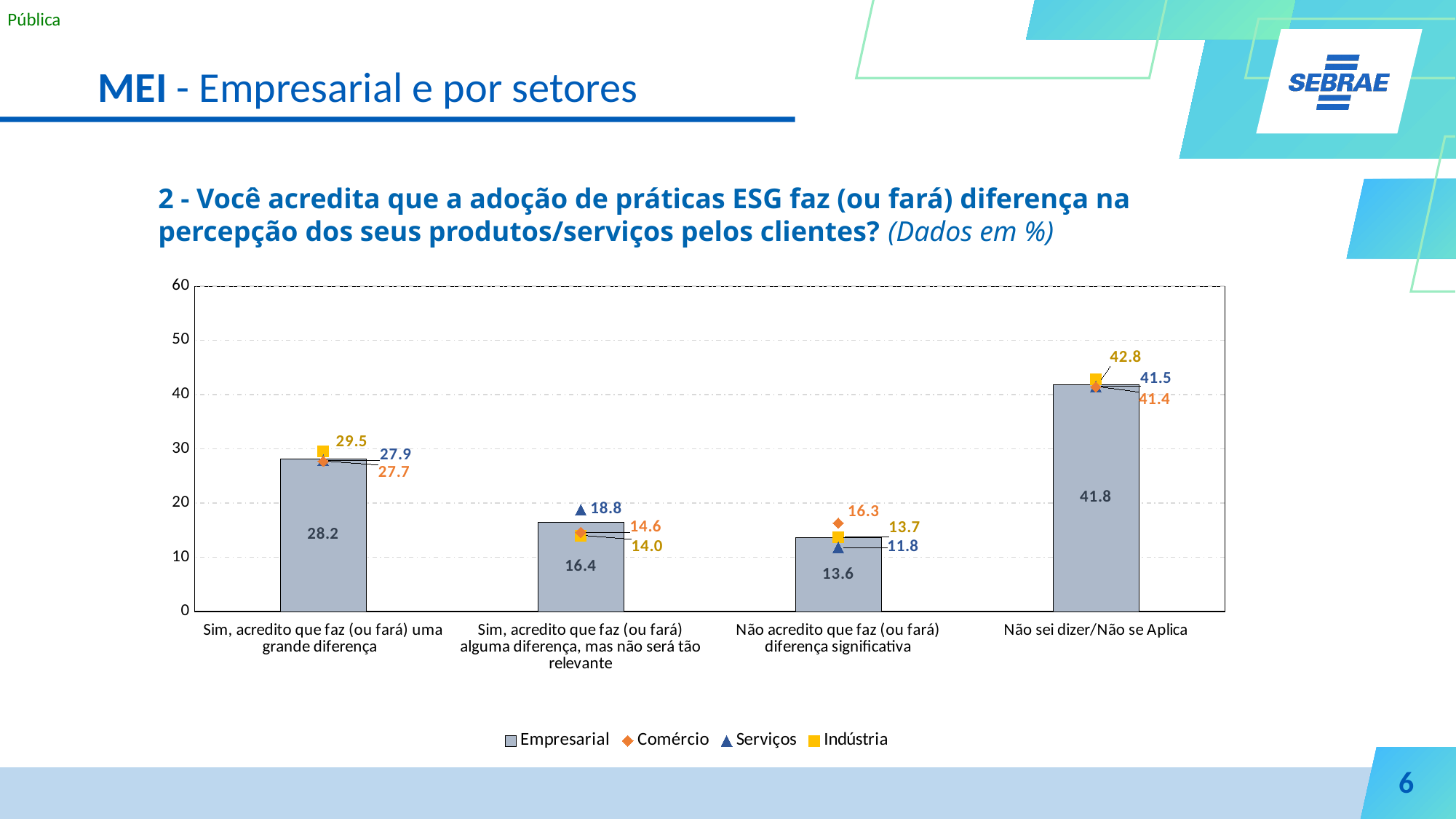
For "Não acredito que faz (ou fará) diferença significativa", which is larger: the Comércio value or the Serviços value? Comércio How many series does the legend list? 4 How many categories are shown on the x axis? 4 What is the Empresarial value for "Não sei dizer/Não se Aplica"? 41.8 Which series is represented by the bars in the chart? Empresarial What is the Serviços value for "Sim, acredito que faz (ou fará) alguma diferença, mas não será tão relevante"? 18.8 Which category has the lowest Empresarial value? Não acredito que faz (ou fará) diferença significativa What is the Indústria value for "Não sei dizer/Não se Aplica"? 42.8 What is the difference between the Empresarial values for "Não sei dizer/Não se Aplica" and "Sim, acredito que faz (ou fará) uma grande diferença"? 13.6 Which category has the highest Empresarial value? Não sei dizer/Não se Aplica What is the Comércio value for "Não acredito que faz (ou fará) diferença significativa"? 16.3 What is the Empresarial value for "Sim, acredito que faz (ou fará) uma grande diferença"? 28.2